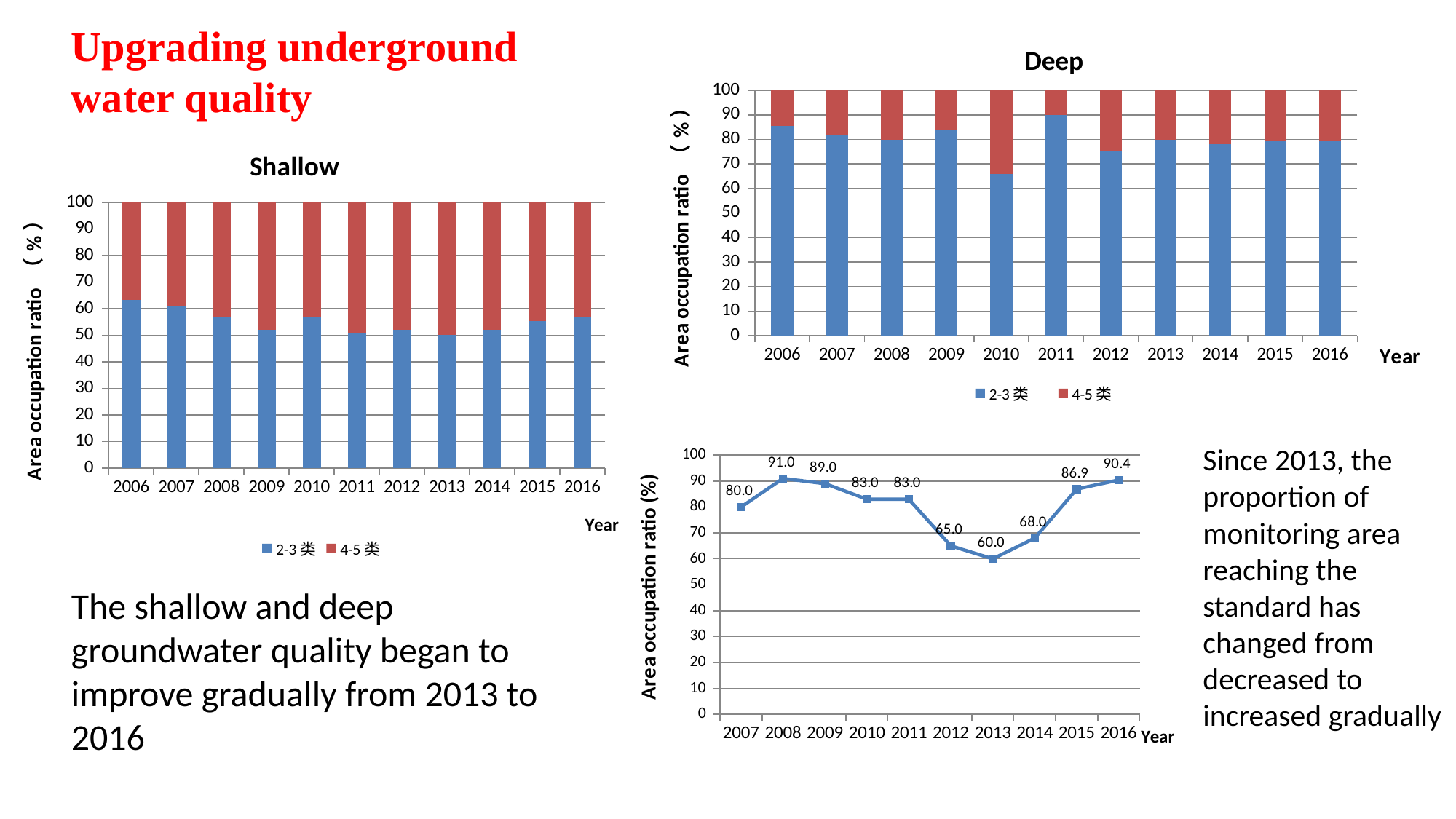
In the bottom-right line chart, do the values rise or fall from 2013 to 2016? rise How many series does the legend of the Shallow chart list? 2 In the bottom-right line chart, what is the value for 2016? 90.4 In the Shallow chart, is the 2-3 类 value for 2006 greater or less than 60? greater In the bottom-right line chart, which year has the lowest value? 2013 In the bottom-right line chart, which year has the highest value? 2008 In the Deep chart, which year has the lowest value for the 2-3 类 series? 2010 In the bottom-right line chart, what is the difference between the values for 2015 and 2014? 18.9 How many years are plotted in the bottom-right line chart? 10 In the bottom-right line chart, what is the value for 2013? 60.0 In the Deep chart, is the 2-3 类 value for 2010 greater or less than 70? less What kind of chart is the bottom-right chart with the data labels? line chart